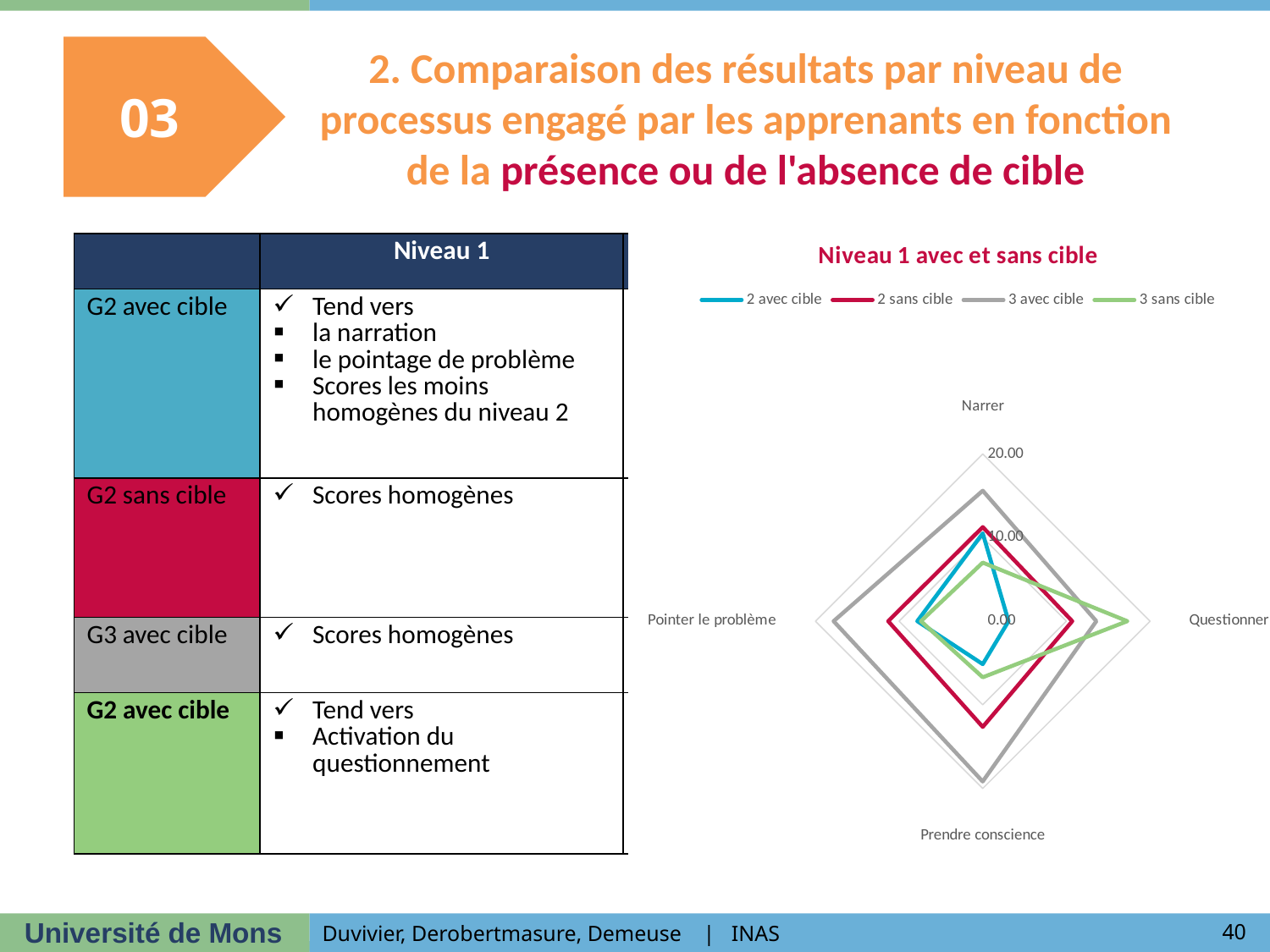
Is the value for 2 avec cible on the Questionner axis greater or less than 10.00? less What kind of chart is shown on the slide? Radar chart Which series has the highest value on the Questionner axis? 3 sans cible Which series is larger on the Narrer axis, 3 avec cible or 3 sans cible? 3 avec cible Is the value for 3 sans cible on the Questionner axis greater or less than 10.00? greater How many series does the chart legend list? 4 Which series has the highest value on the Prendre conscience axis? 3 avec cible Is the value for 3 avec cible on the Pointer le problème axis greater or less than 10.00? greater What is the title of the chart? Niveau 1 avec et sans cible How many categories (axes) does the radar chart have? 4 Which series has the lowest value on the Questionner axis? 2 avec cible